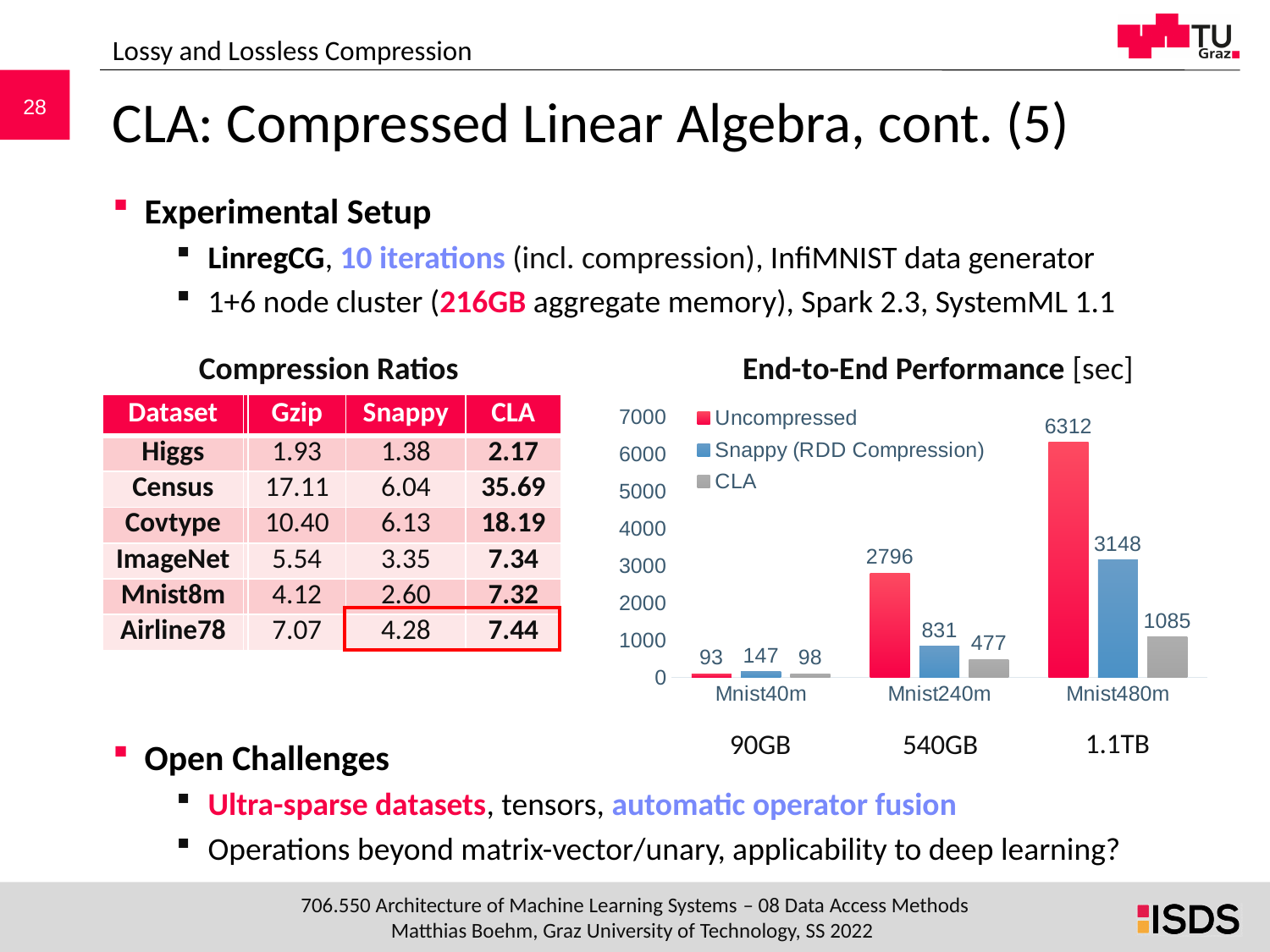
In the End-to-End Performance chart, what is the value for Snappy (RDD Compression) on Mnist40m? 147 In the End-to-End Performance chart, is the Snappy (RDD Compression) value for Mnist480m greater or less than 3000? greater In the End-to-End Performance chart, which dataset has the highest Uncompressed value? Mnist480m In the End-to-End Performance chart, do the CLA values rise or fall from Mnist40m to Mnist480m? rise What kind of chart is the End-to-End Performance chart? bar chart In the End-to-End Performance chart, what is the value for CLA on Mnist240m? 477 In the End-to-End Performance chart, which dataset has the lowest CLA value? Mnist40m How many dataset categories are shown on the x axis of the End-to-End Performance chart? 3 In the End-to-End Performance chart, what is the value for Uncompressed on Mnist480m? 6312 How many series does the legend of the End-to-End Performance chart list? 3 In the End-to-End Performance chart, which is larger on Mnist480m: Snappy (RDD Compression) or CLA? Snappy (RDD Compression) In the End-to-End Performance chart, what is the difference between the Uncompressed and CLA values on Mnist240m? 2319